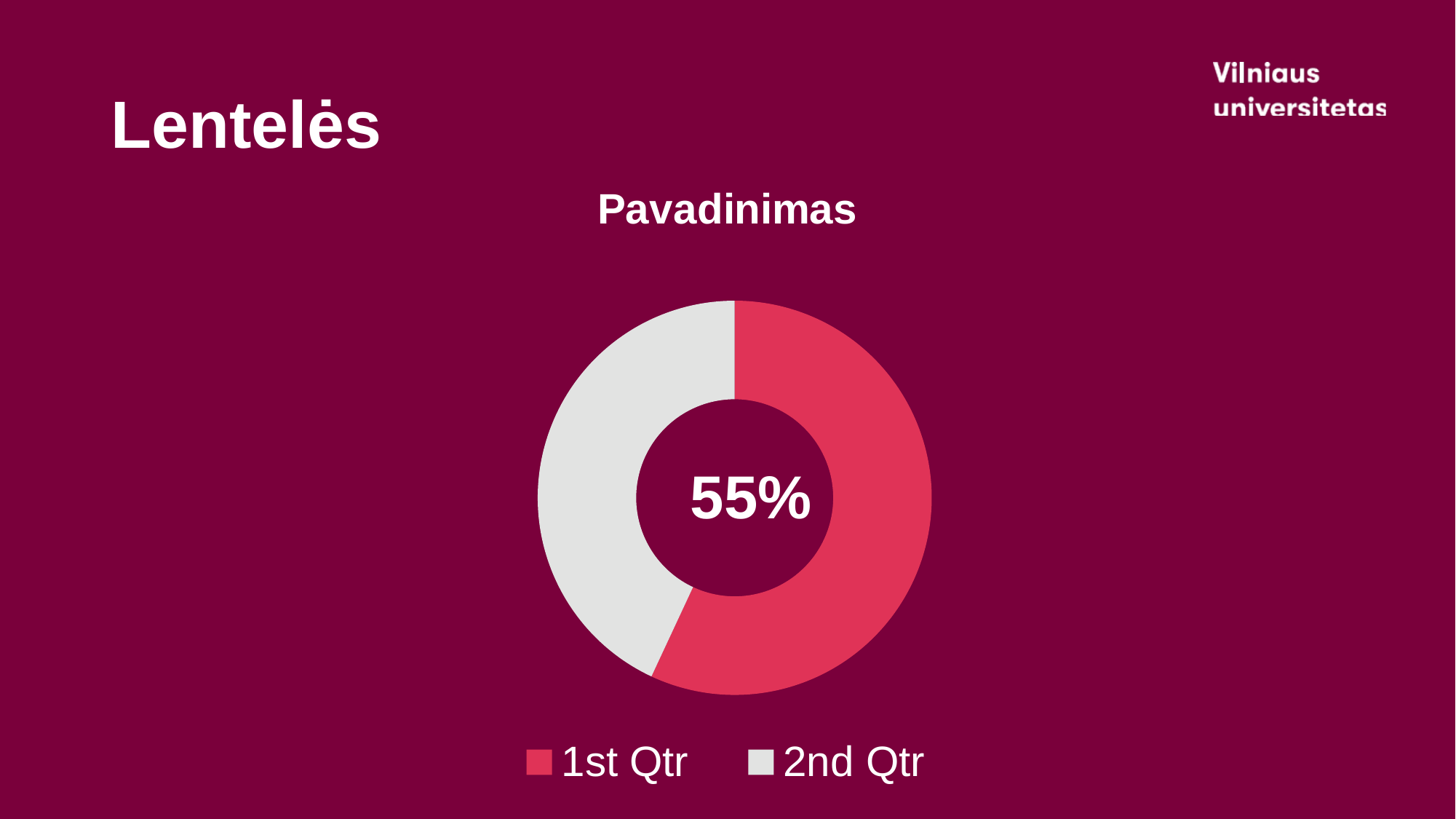
What is the title of the chart? Pavadinimas Which slice is the smallest in the chart? 2nd Qtr What kind of chart is shown on the slide? doughnut chart What percentage is printed in the centre of the doughnut chart? 55% Is the share for 2nd Qtr greater or less than 50%? less Which slice is the largest in the chart? 1st Qtr How many slices does the doughnut chart have? 2 What colour represents 1st Qtr in the chart? red Which is larger, the 1st Qtr slice or the 2nd Qtr slice? 1st Qtr How many entries does the chart legend list? 2 Is the share for 1st Qtr greater or less than 50%? greater